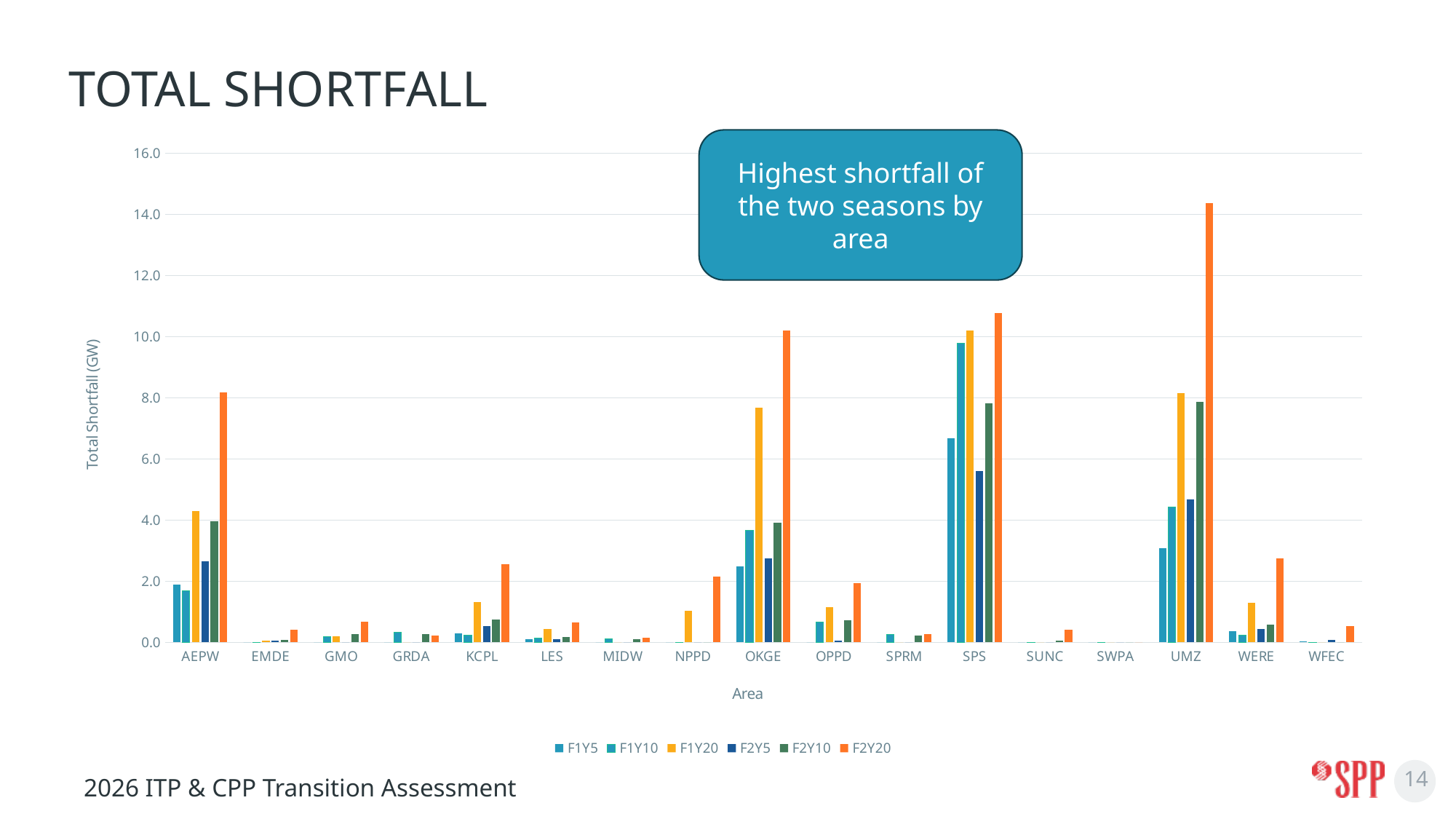
Is the F2Y20 value for SPS greater or less than 10.0? greater Which area has the highest F2Y20 bar? UMZ Is the F2Y20 value for UMZ greater or less than 14.0? greater Which area has the highest F1Y20 bar? SPS How many areas are shown along the x axis of the chart? 17 Is the F2Y20 value for WERE greater or less than 4.0? less What kind of chart is shown on the slide? Bar chart How many series does the chart's legend list? 6 Which is larger, the F2Y20 value for OKGE or the F2Y20 value for AEPW? OKGE What is the label of the chart's vertical axis? Total Shortfall (GW) Which is larger, the F1Y20 value for SPS or the F1Y20 value for UMZ? SPS